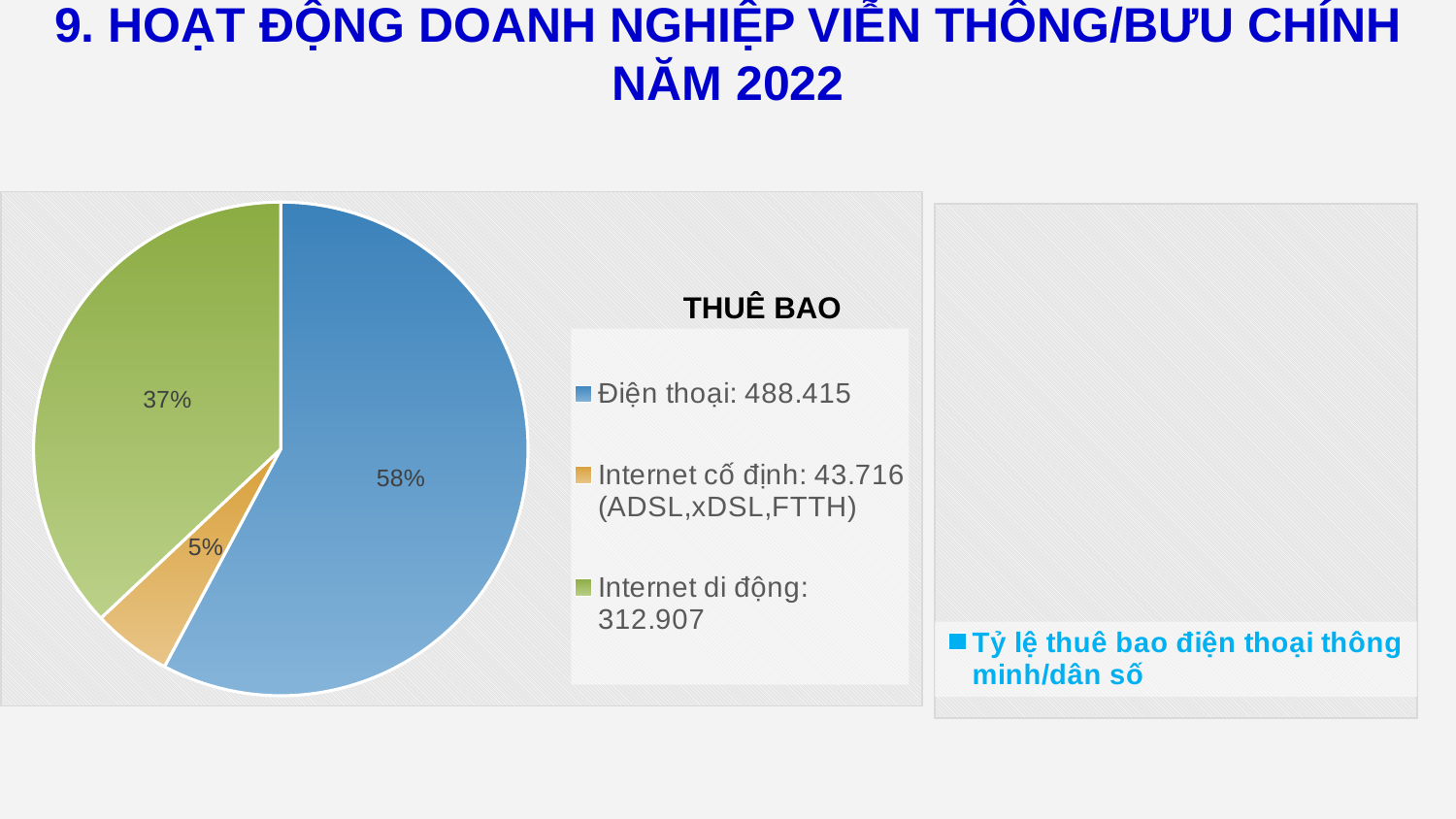
In the pie chart titled THUÊ BAO, which slice is larger: Internet di động or Internet cố định (ADSL,xDSL,FTTH)? Internet di động In the pie chart titled THUÊ BAO, what share of the pie does Điện thoại take? 58% In the pie chart titled THUÊ BAO, which category has the smallest slice? Internet cố định (ADSL,xDSL,FTTH) In the pie chart titled THUÊ BAO, which category has the largest slice? Điện thoại In the pie chart titled THUÊ BAO, what is the difference in percentage points between the Điện thoại slice and the Internet di động slice? 21% In the pie chart titled THUÊ BAO, how many slices does the pie have? 3 In the pie chart titled THUÊ BAO, what is the number of subscribers shown in the legend for Internet cố định (ADSL,xDSL,FTTH)? 43.716 In the pie chart titled THUÊ BAO, what is the number of subscribers shown in the legend for Internet di động? 312.907 In the pie chart titled THUÊ BAO, what share of the pie does Internet cố định (ADSL,xDSL,FTTH) take? 5% In the pie chart titled THUÊ BAO, what share of the pie does Internet di động take? 37% What type of chart is the chart on the left of the slide? Pie chart In the pie chart titled THUÊ BAO, what is the number of subscribers shown in the legend for Điện thoại? 488.415